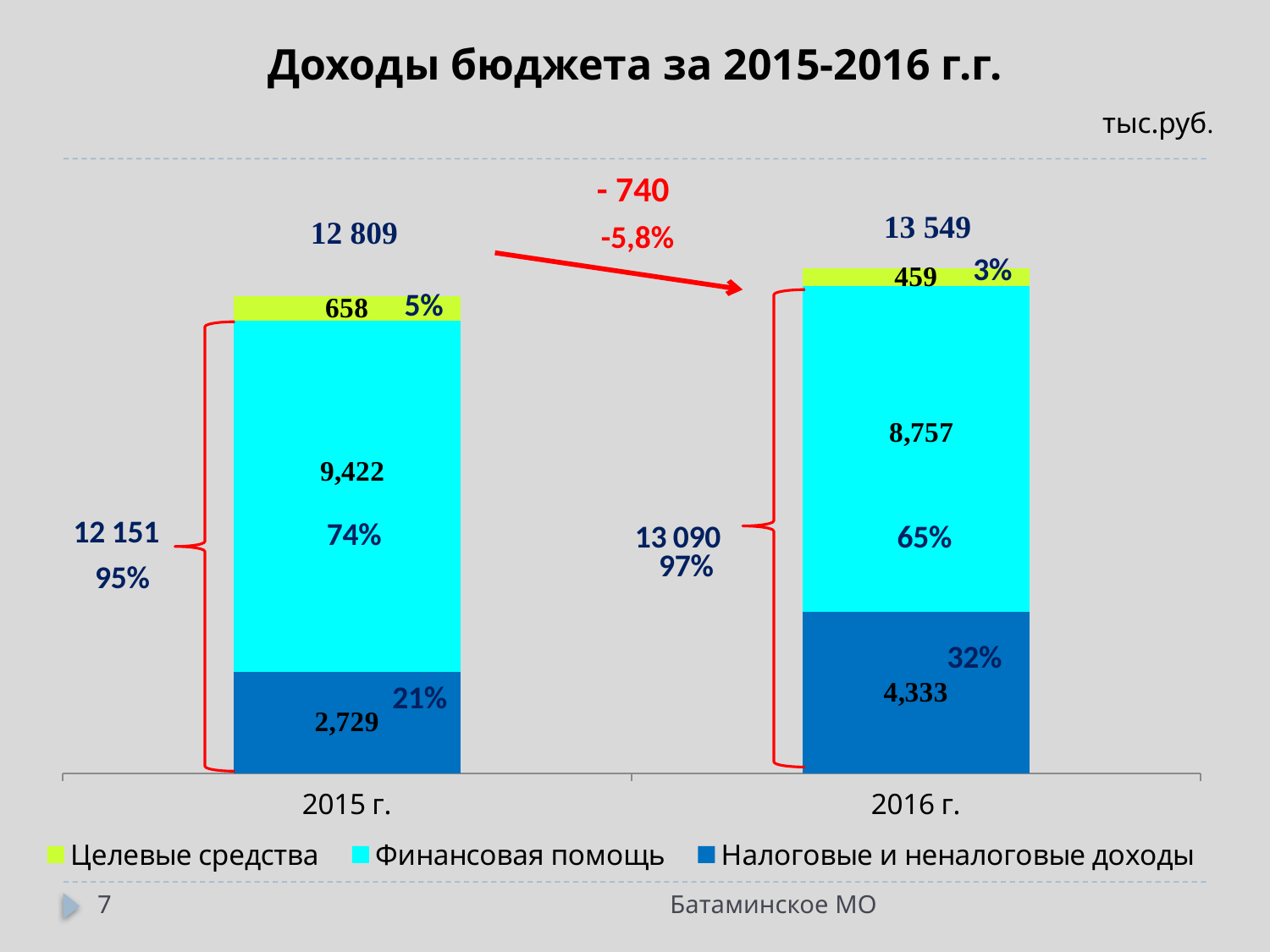
What is the title of the chart? Доходы бюджета за 2015-2016 г.г. How many categories are shown on the x axis? 2 What type of chart is shown on the slide? stacked bar chart What is the total of the stacked bar for 2016 г.? 13 549 What is the difference between the Целевые средства values for 2015 г. and 2016 г.? 199 Which year has the larger value for Налоговые и неналоговые доходы, 2015 г. or 2016 г.? 2016 г. What is the value of Целевые средства for 2015 г.? 658 What is the total of the stacked bar for 2015 г.? 12 809 What is the value of Финансовая помощь for 2015 г.? 9,422 How many series does the legend list? 3 What is the value of Налоговые и неналоговые доходы for 2016 г.? 4,333 What percentage share does Финансовая помощь have in 2016 г.? 65%